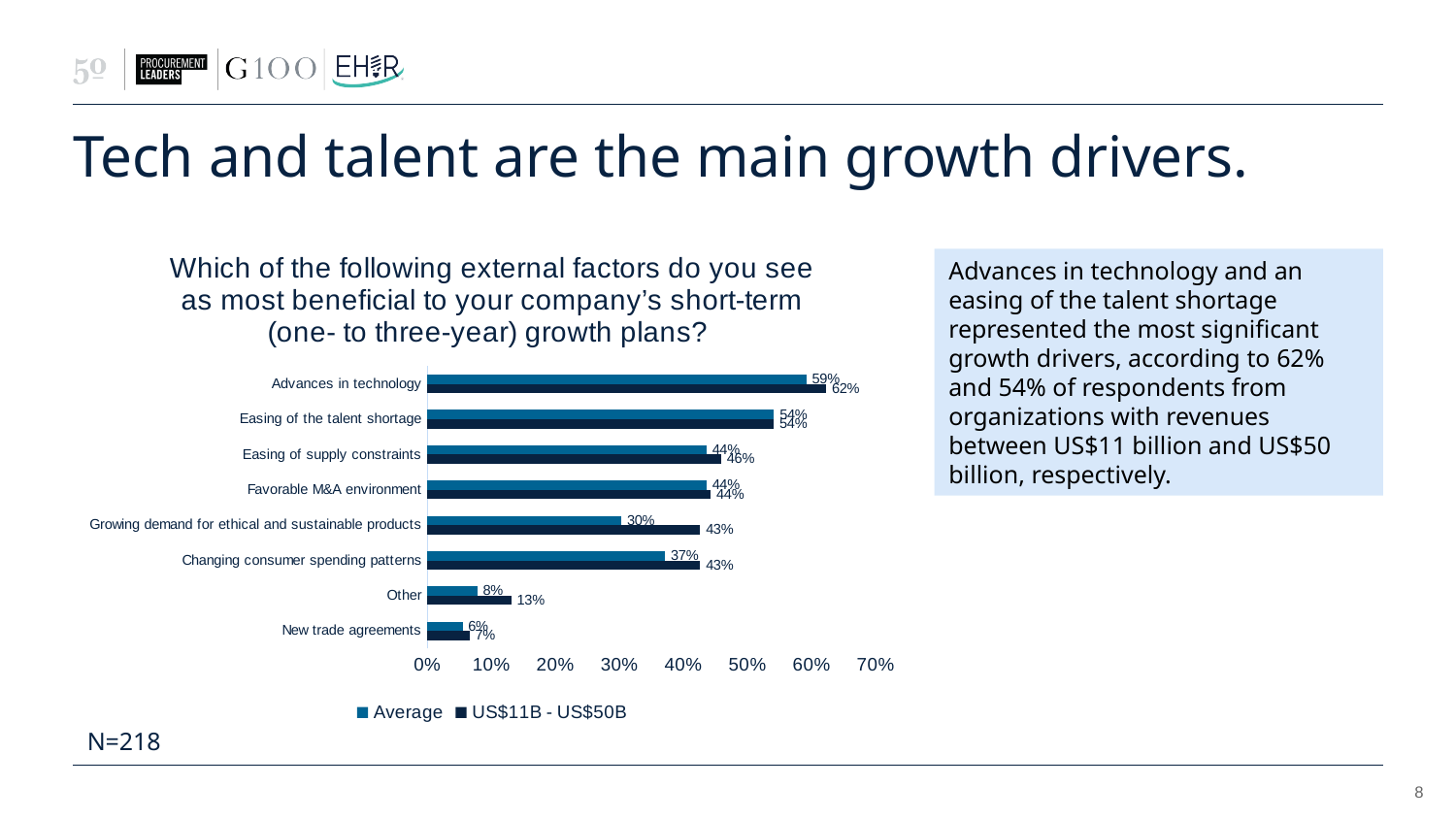
For Changing consumer spending patterns, which is larger: the Average value or the US$11B - US$50B value? US$11B - US$50B What kind of chart is shown on the slide? Bar chart What is the US$11B - US$50B value for Advances in technology? 62% What is the sample size (N) stated on the slide? N=218 What is the Average value for Other? 8% How many external factors (categories) are plotted in the chart? 8 Which category has the highest Average value? Advances in technology How many series does the legend list? 2 Which category has the lowest US$11B - US$50B value? New trade agreements What is the Average value for Advances in technology? 59% What is the US$11B - US$50B value for Growing demand for ethical and sustainable products? 43% What is the difference between the US$11B - US$50B value and the Average value for Growing demand for ethical and sustainable products? 13%